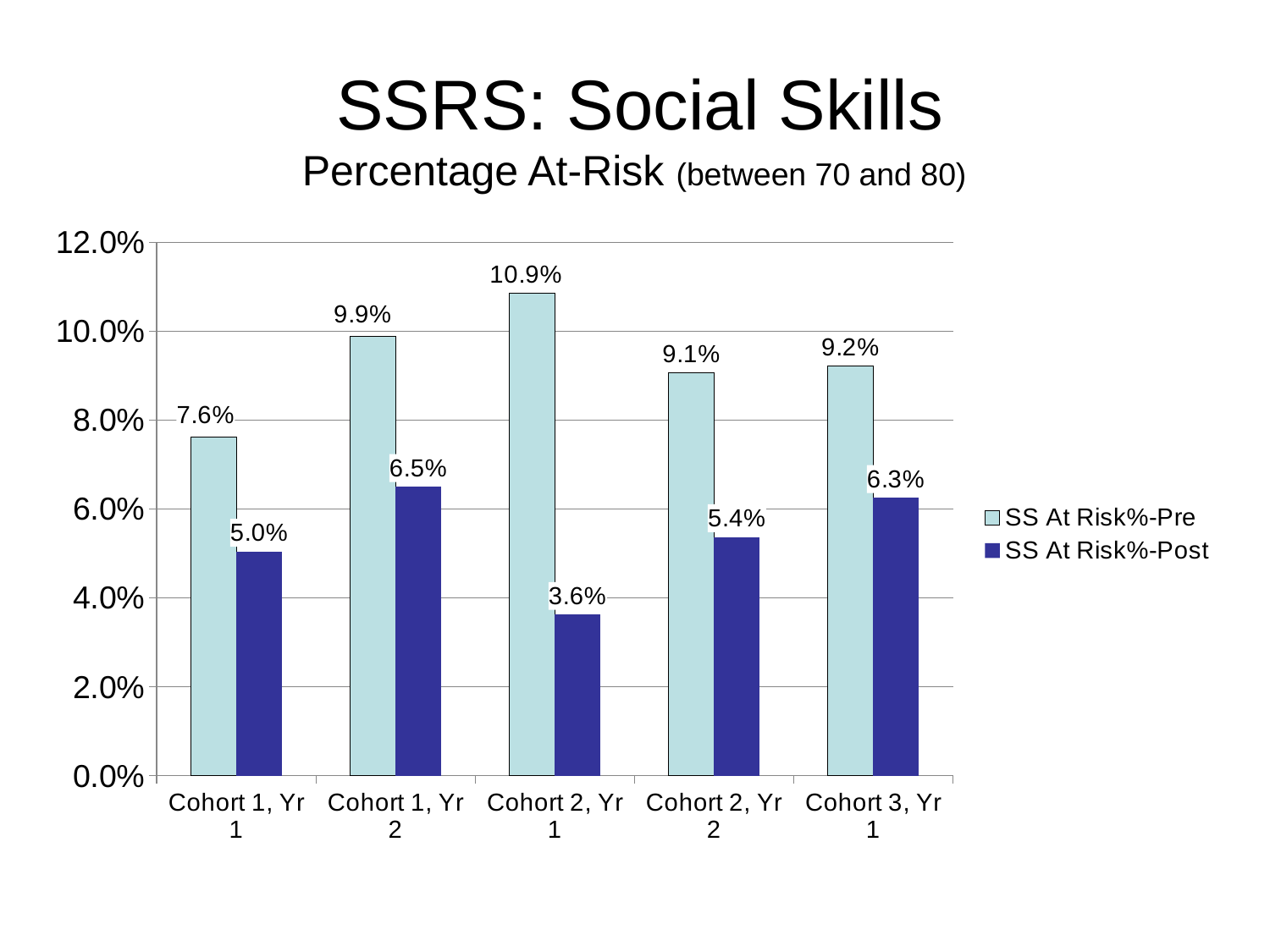
What kind of chart is shown on the slide? Bar chart How many categories are shown on the x axis? 5 What is the difference between the SS At Risk%-Pre and SS At Risk%-Post values for Cohort 2, Yr 1? 7.3% Which is larger for Cohort 1, Yr 1: the SS At Risk%-Pre value or the SS At Risk%-Post value? SS At Risk%-Pre What is the SS At Risk%-Pre value for Cohort 2, Yr 1? 10.9% What is the SS At Risk%-Post value for Cohort 1, Yr 2? 6.5% What is the SS At Risk%-Post value for Cohort 3, Yr 1? 6.3% Which category has the highest SS At Risk%-Pre value? Cohort 2, Yr 1 Which category has the lowest SS At Risk%-Post value? Cohort 2, Yr 1 How many series does the legend list? 2 Is the SS At Risk%-Pre value for Cohort 1, Yr 2 greater or less than 8.0%? greater What is the title of the chart on the slide? SSRS: Social Skills Percentage At-Risk (between 70 and 80)